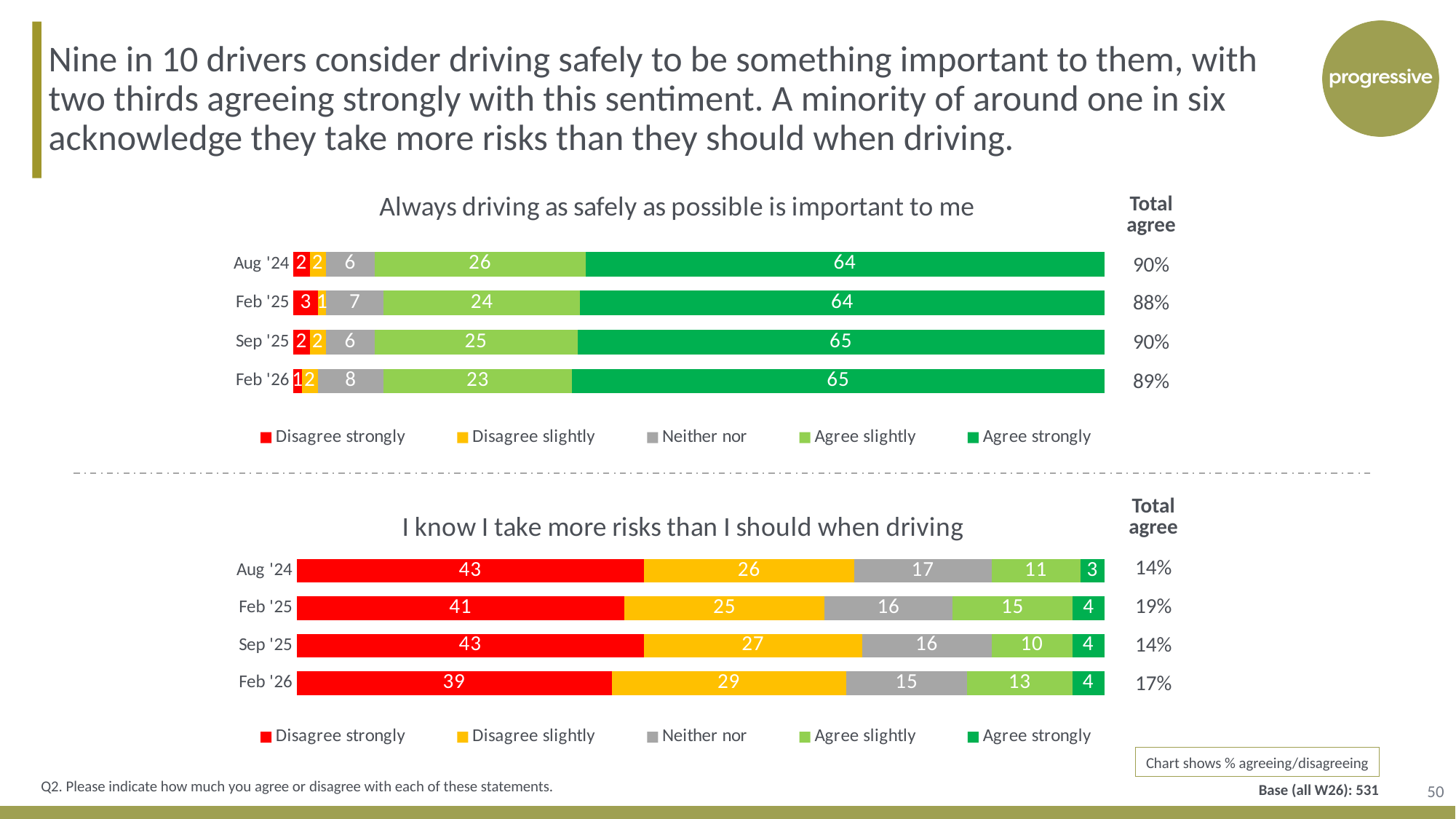
In the chart 'I know I take more risks than I should when driving', what is the 'Disagree strongly' value for Feb '26? 39 In the chart 'Always driving as safely as possible is important to me', what is the 'Neither nor' value for Feb '26? 8 What type of chart is 'I know I take more risks than I should when driving'? Stacked bar chart In the chart 'Always driving as safely as possible is important to me', what is the Total agree figure for Feb '25? 88% How many series does the legend of the chart 'Always driving as safely as possible is important to me' list? 5 How many waves (categories) are shown in the chart 'I know I take more risks than I should when driving'? 4 In the chart 'I know I take more risks than I should when driving', which wave has the highest Total agree figure? Feb '25 In the chart 'Always driving as safely as possible is important to me', which is larger: the 'Agree slightly' value for Aug '24 or for Feb '26? Aug '24 In the chart 'I know I take more risks than I should when driving', what is the total of the 'Agree slightly' and 'Agree strongly' values for Sep '25? 14 In the chart 'I know I take more risks than I should when driving', which wave has the lowest 'Disagree strongly' value? Feb '26 In the chart 'Always driving as safely as possible is important to me', what is the 'Agree strongly' value for Aug '24? 64 In the chart 'I know I take more risks than I should when driving', what is the difference between the 'Disagree slightly' values for Feb '26 and Feb '25? 4